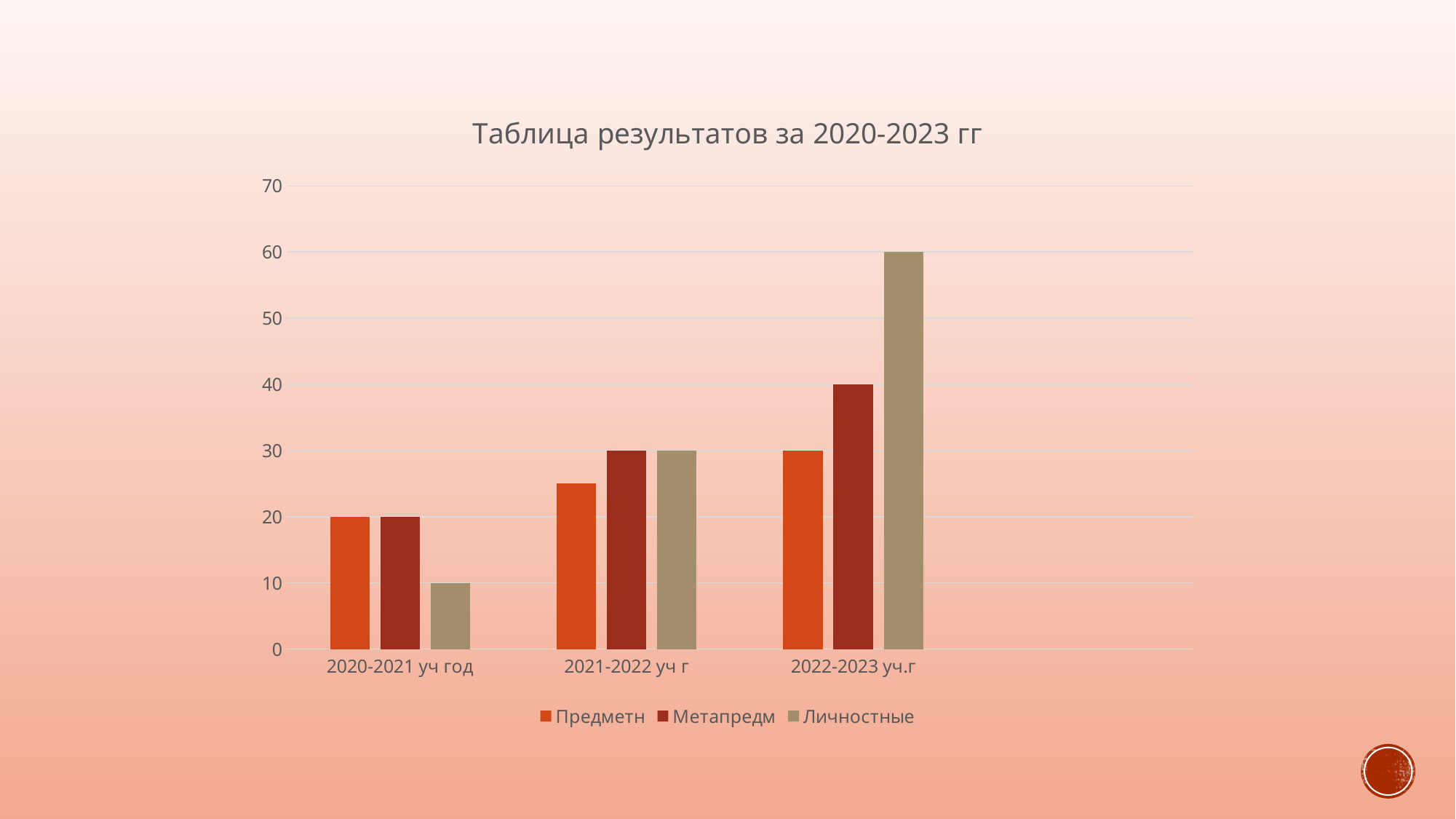
How many series does the legend list? 3 How many categories are shown on the x axis? 3 Which category has the highest value for Личностные? 2022-2023 уч.г What kind of chart is shown on the slide? bar chart What is the difference between Личностные in 2022-2023 уч.г and Личностные in 2020-2021 уч год? 50 Does the value for Личностные rise or fall from 2020-2021 уч год to 2022-2023 уч.г? rise What is the value for Личностные in 2020-2021 уч год? 10 Is the value for Предметн in 2021-2022 уч г greater or less than 20? greater What is the value for Метапредм in 2022-2023 уч.г? 40 What is the value for Личностные in 2022-2023 уч.г? 60 Which category has the lowest value for Метапредм? 2020-2021 уч год What is the title of the chart? Таблица результатов за 2020-2023 гг